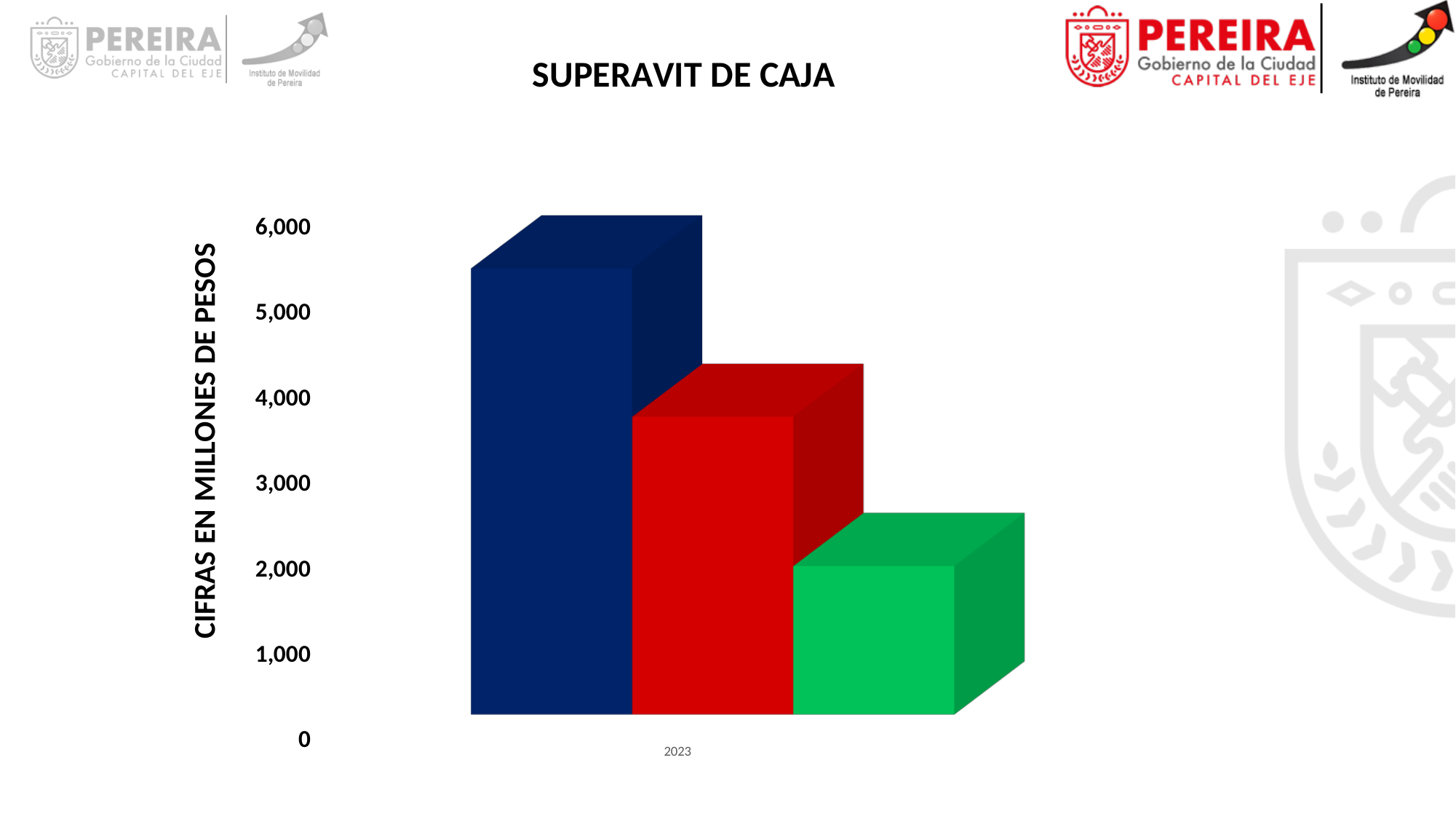
Is the value of the red bar greater or less than 5,000? less How many bars are plotted in the chart? 3 Which bar is the tallest in the chart? the blue bar Is the value of the blue bar greater or less than 4,000? greater Which is larger, the red bar or the green bar? the red bar What kind of chart is shown on the slide? bar chart Which bar is the shortest in the chart? the green bar How many categories are shown on the x axis of the chart? 1 Is the value of the green bar greater or less than 3,000? less What is the title of the chart? SUPERAVIT DE CAJA What is the label on the vertical axis of the chart? CIFRAS EN MILLONES DE PESOS Which is larger, the blue bar or the red bar? the blue bar